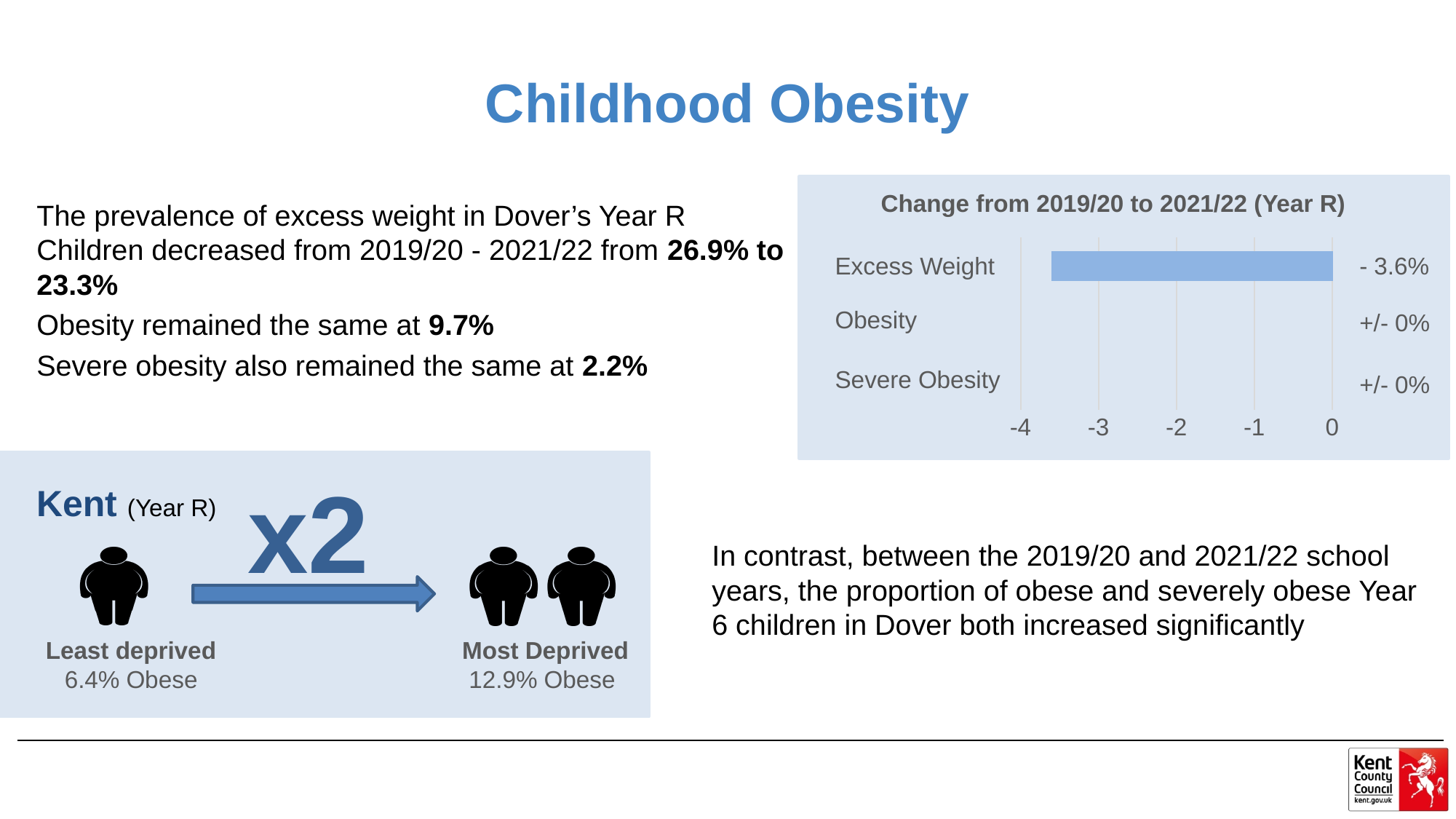
What is the change shown for Excess Weight in the chart? - 3.6% How many categories does the chart show? 3 Is the value for Excess Weight in the chart greater or less than -3? less Is the value for Excess Weight in the chart greater or less than -4? greater What is the difference between the change for Excess Weight and the change for Severe Obesity in the chart? 3.6% Which category in the chart shows the largest decrease? Excess Weight What is the lowest value shown on the chart's horizontal axis? -4 What is the title of the chart on the slide? Change from 2019/20 to 2021/22 (Year R) What is the change shown for Severe Obesity in the chart? +/- 0% What type of chart is shown on the slide? bar chart Which category in the chart has a larger decrease, Excess Weight or Obesity? Excess Weight What is the change shown for Obesity in the chart? +/- 0%